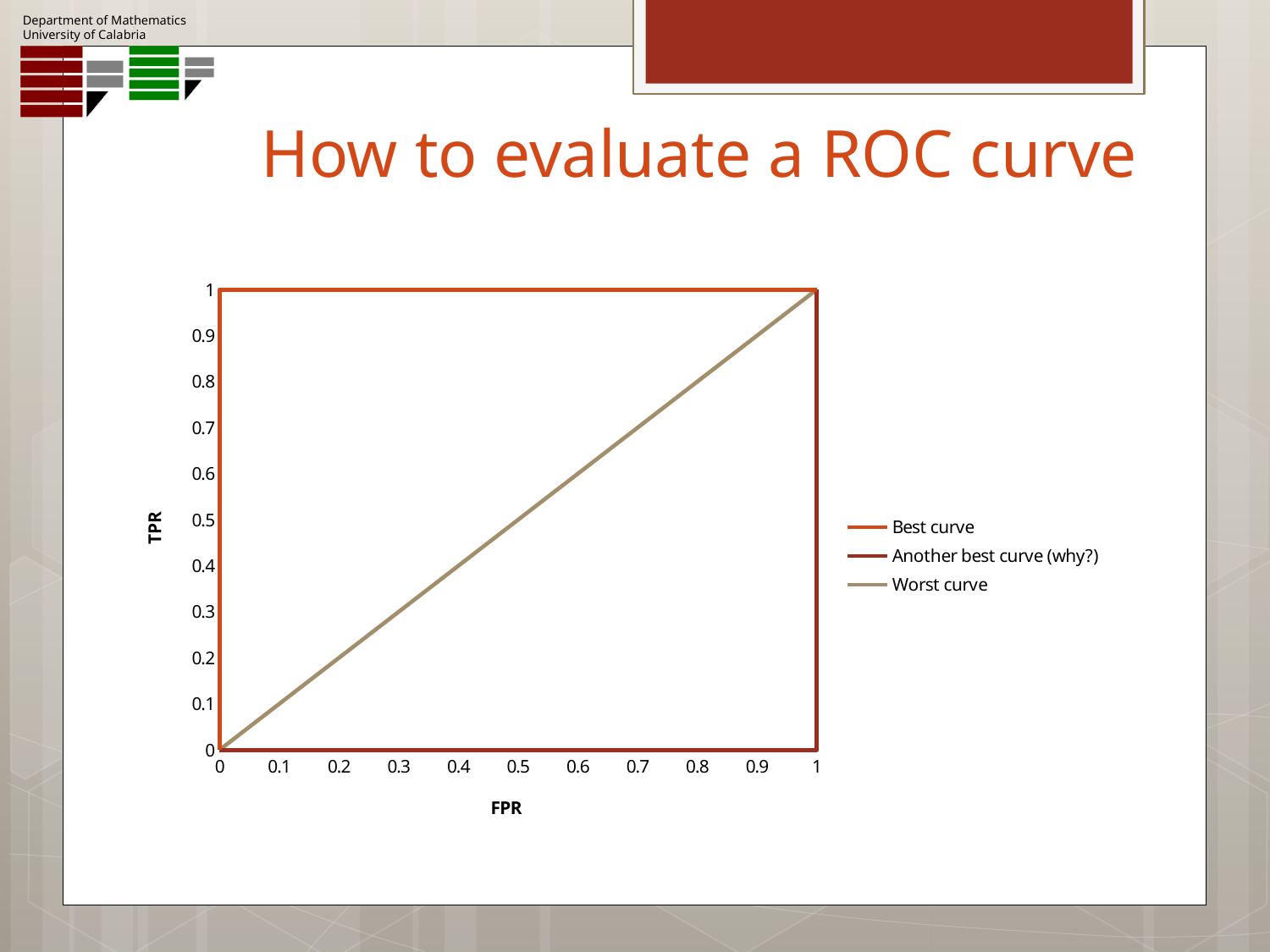
How many series does the legend list? 3 What is the label of the y axis? TPR What kind of chart is shown on the slide? line chart What is the maximum value shown on the TPR axis? 1 At FPR = 0.2, is the TPR of the Worst curve greater or less than 0.5? less Does the Worst curve rise or fall as FPR increases? rise At FPR = 0.8, is the TPR of the Worst curve greater or less than 0.5? greater At FPR = 0.1, is the TPR of the Best curve greater or less than 0.9? greater What is the minimum value shown on the FPR axis? 0 At FPR = 0.5, which series has the higher TPR, the Best curve or the Worst curve? Best curve What is the label of the x axis? FPR